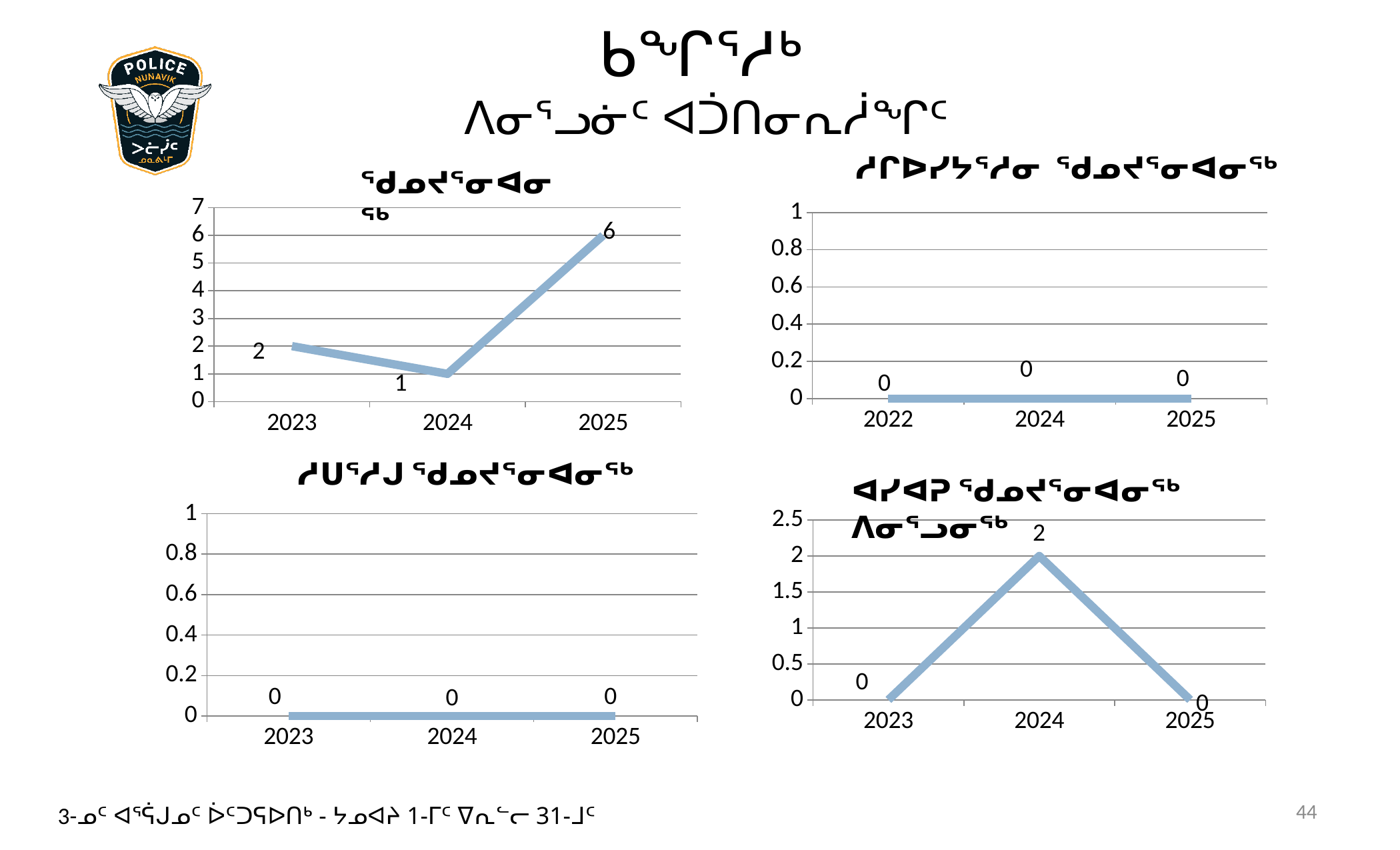
How many charts are shown on the slide? 4 In the top-left chart, what is the difference between the values for 2025 and 2023? 4 In the top-left chart, what is the value for 2025? 6 In the top-left chart, which year has the lowest value? 2024 In the top-right chart, what is the value for 2022? 0 What kind of chart is the top-left chart? line chart In the bottom-left chart, how many years are plotted on the x axis? 3 In the bottom-right chart, what is the value for 2024? 2 In the top-left chart, which year has the highest value? 2025 In the top-left chart, what is the value for 2024? 1 In the bottom-right chart, which year has the highest value? 2024 In the top-left chart, is the value for 2023 larger or smaller than the value for 2024? larger